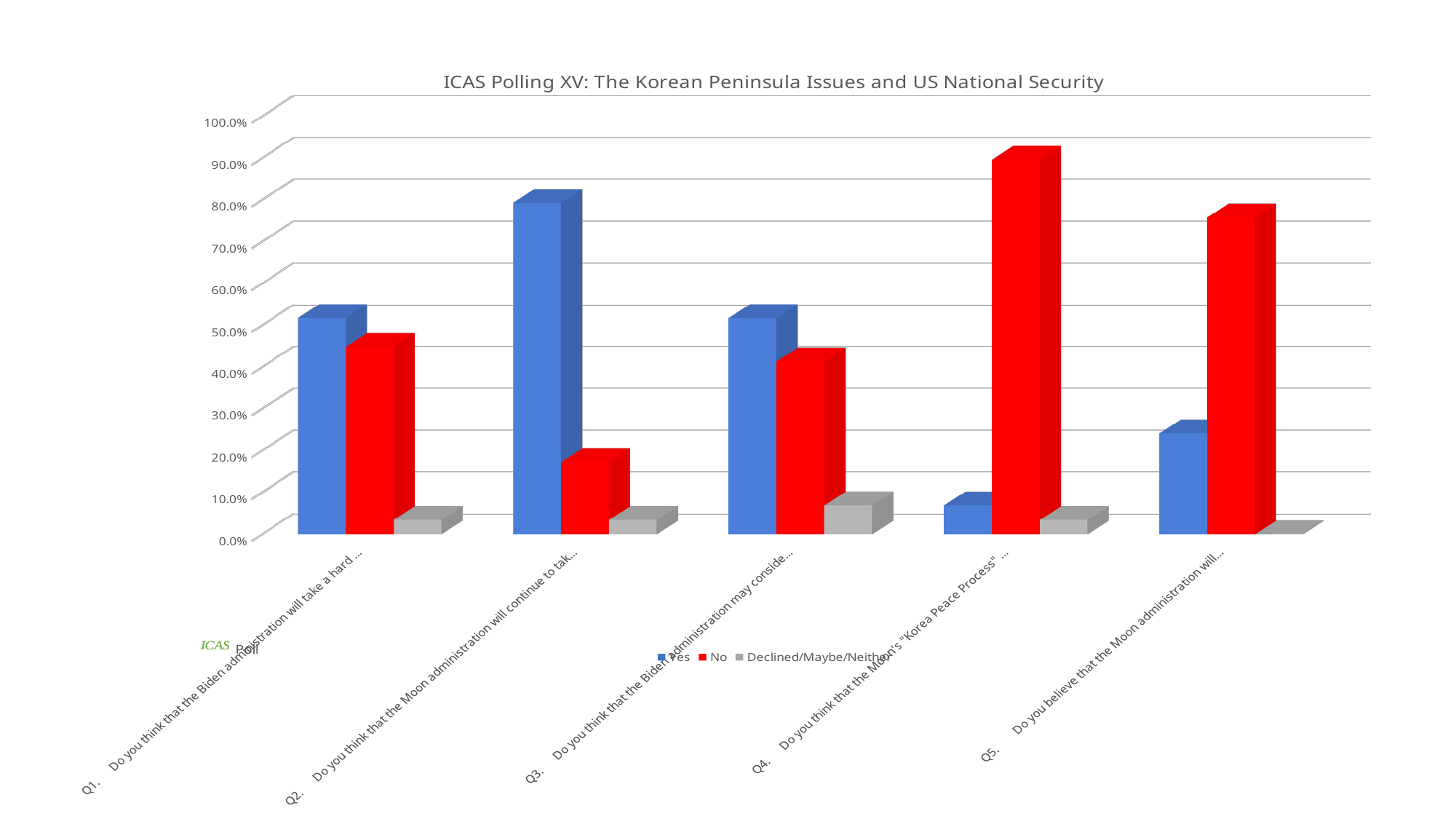
Is the "Yes" value for Q2 greater or less than 70.0%? greater How many question categories are plotted along the x axis? 5 Is the "No" value for Q4 greater or less than 80.0%? greater For Q5, which is larger, the "Yes" value or the "No" value? No What kind of chart is shown on the slide? bar chart For Q2, which is larger, the "Yes" value or the "No" value? Yes Which question has the lowest "Yes" value? Q4 Which question has the highest "Yes" value? Q2 What is the title of the chart? ICAS Polling XV: The Korean Peninsula Issues and US National Security Is the "Yes" value for Q5 greater or less than 40.0%? less Which question has the highest "No" value? Q4 How many series does the legend list? 3